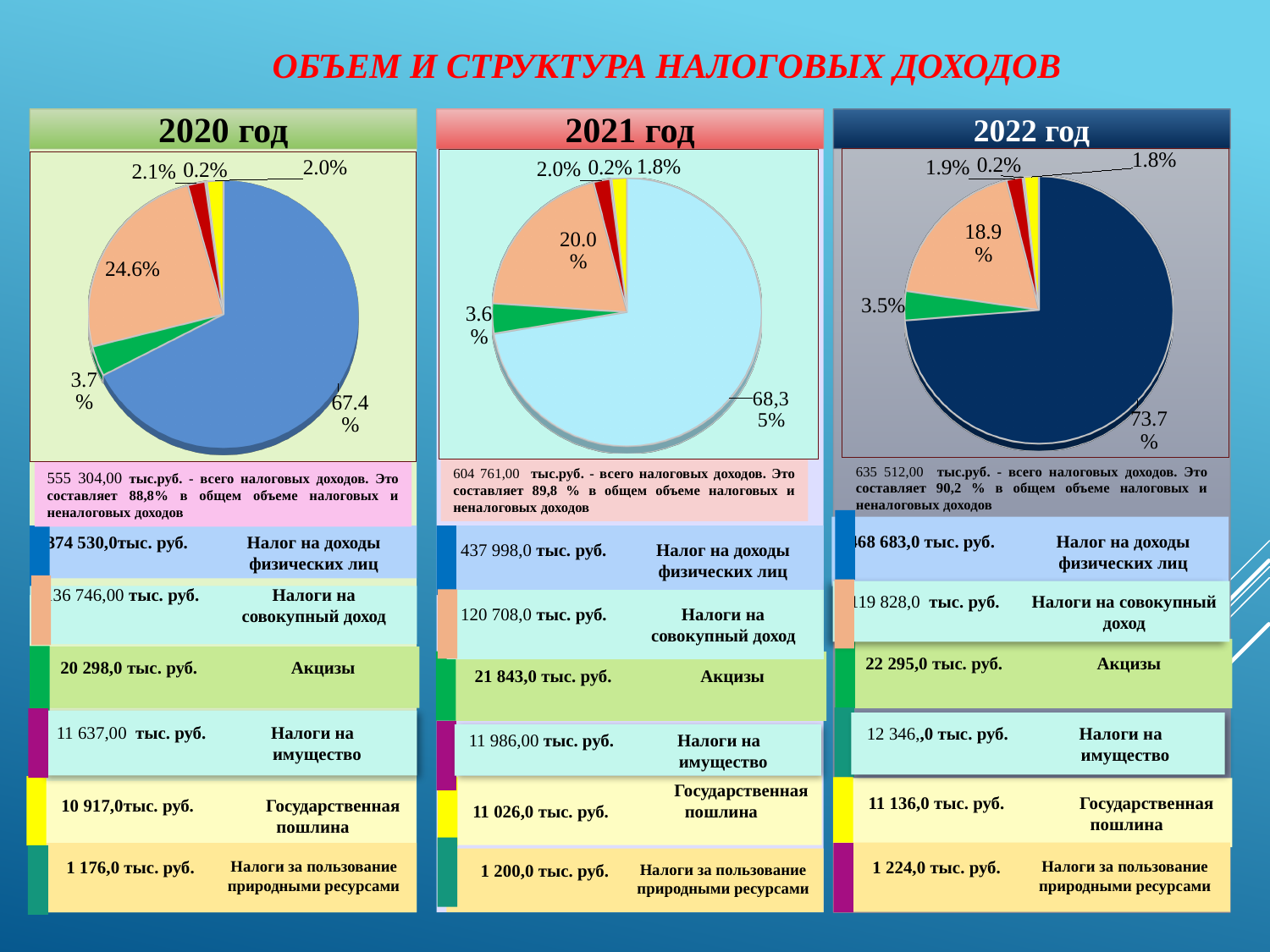
How many pie charts are shown on the slide? 3 How many slices does the 2020 год pie chart have? 6 In the 2022 год pie chart, what is the share of the largest slice? 73.7% In the 2022 год pie chart, what is the share of the green slice? 3.5% What is the difference between the largest slice in the 2022 год pie chart and the largest slice in the 2020 год pie chart? 6.3 percentage points Which is larger: the orange slice in the 2020 год pie chart (24.6%) or the orange slice in the 2021 год pie chart (20.0%)? 2020 год (24.6%) In the 2021 год pie chart, what is the share of the largest slice? 68,35% Does the share of the largest slice rise or fall from the 2020 год chart to the 2022 год chart? rise In the 2020 год pie chart, what is the share of the largest slice? 67.4% What kind of chart is used for the 2020 год panel? pie chart What is the title of the slide containing the three pie charts? ОБЪЕМ И СТРУКТУРА НАЛОГОВЫХ ДОХОДОВ In the 2020 год pie chart, what is the share of the smallest slice? 0.2%